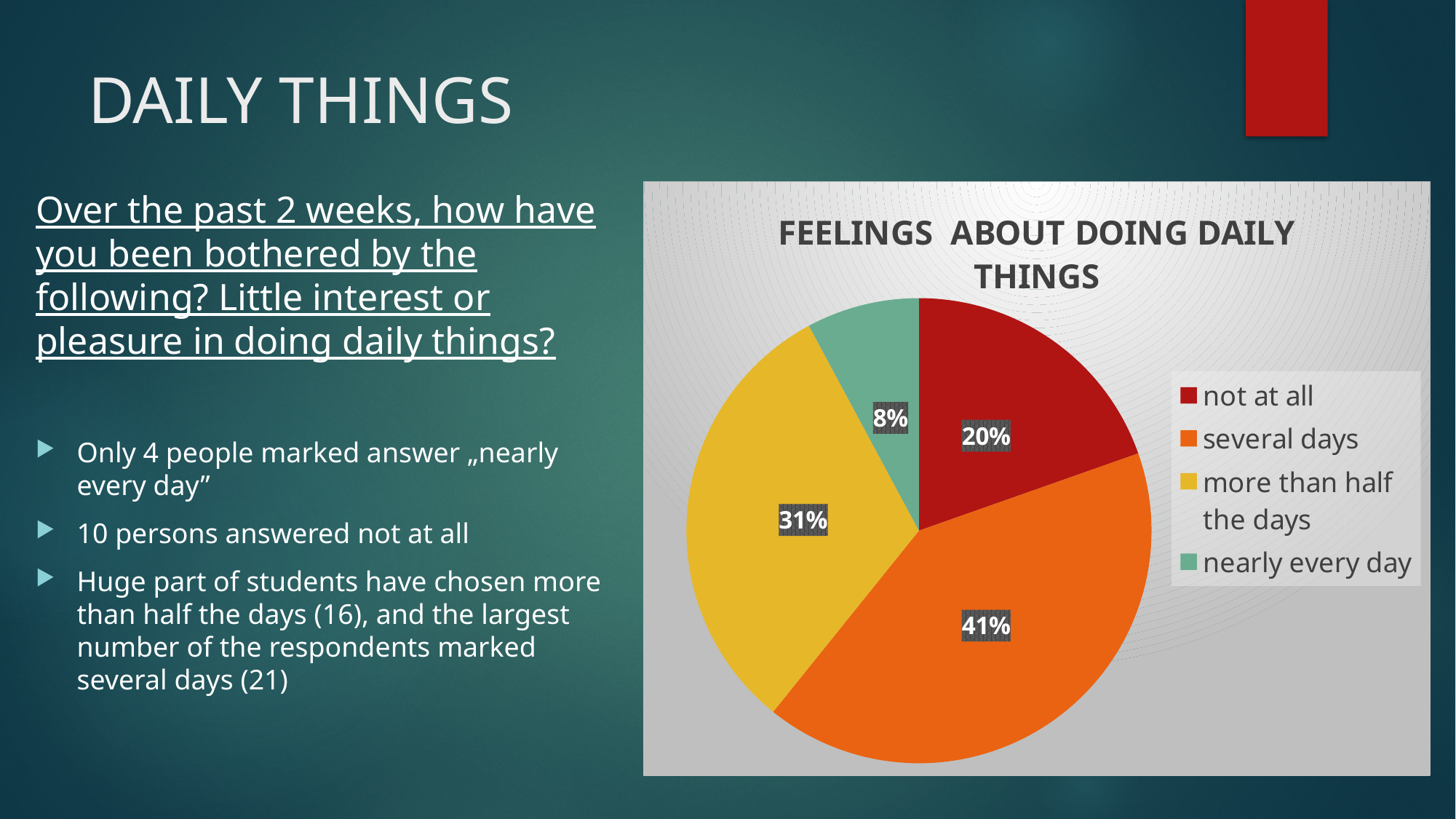
How many categories does the pie chart have? 4 What colour is the slice for "nearly every day"? green What kind of chart is shown on the slide? pie chart What is the difference in percentage points between "several days" and "more than half the days"? 10 Which category has the largest slice of the pie? several days What share of the pie is labelled "several days"? 41% What is the title of the chart? FEELINGS ABOUT DOING DAILY THINGS What share of the pie is labelled "nearly every day"? 8% What share of the pie is labelled "more than half the days"? 31% Which category has the smallest slice of the pie? nearly every day Which is larger, the slice for "not at all" or the slice for "more than half the days"? more than half the days